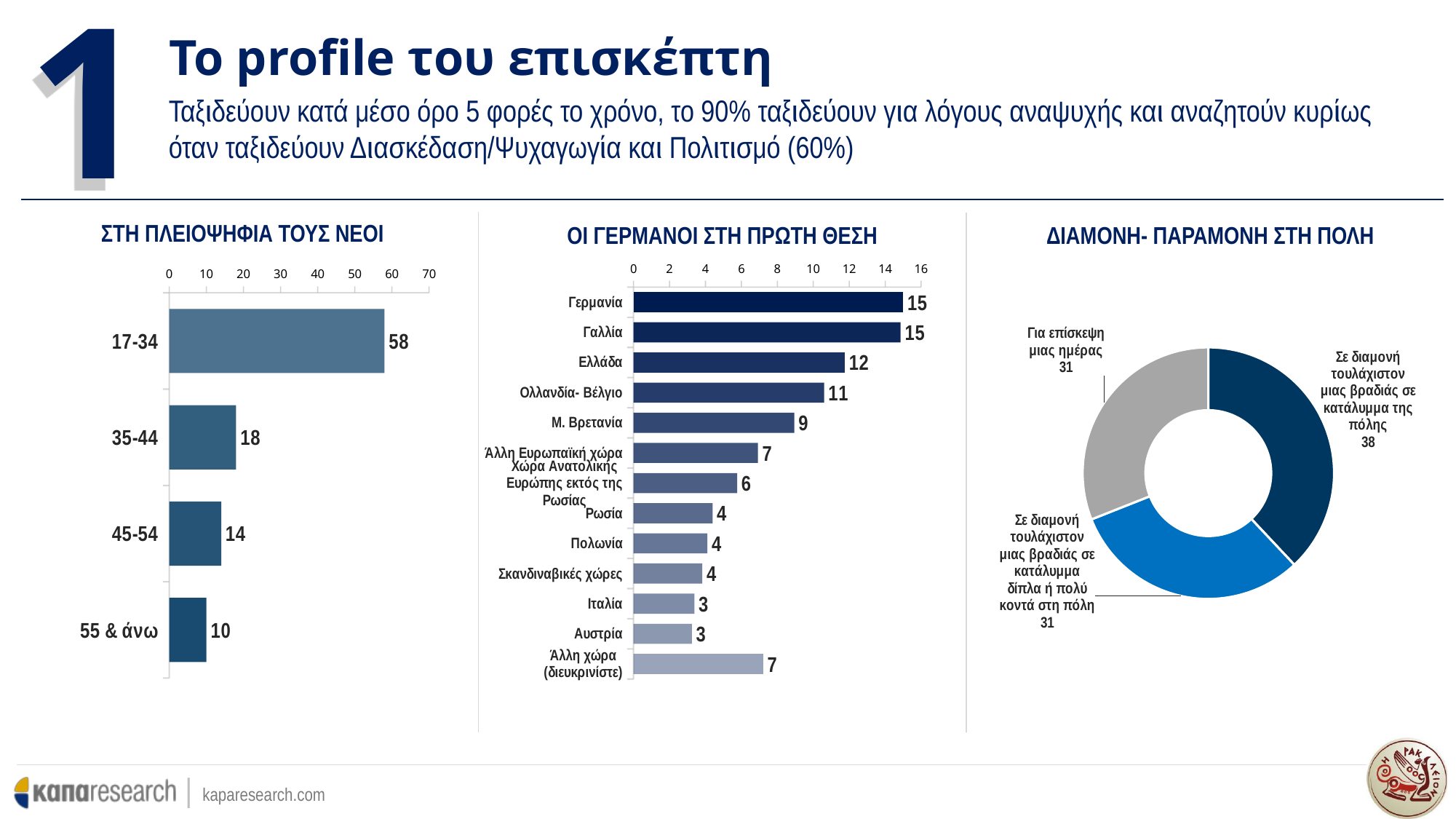
In the chart titled 'ΟΙ ΓΕΡΜΑΝΟΙ ΣΤΗ ΠΡΩΤΗ ΘΕΣΗ', what is the value for Ελλάδα? 12 What kind of chart is the one titled 'ΣΤΗ ΠΛΕΙΟΨΗΦΙΑ ΤΟΥΣ ΝΕΟΙ'? Bar chart In the chart titled 'ΣΤΗ ΠΛΕΙΟΨΗΦΙΑ ΤΟΥΣ ΝΕΟΙ', what is the difference between the values for 35-44 and 45-54? 4 In the chart titled 'ΟΙ ΓΕΡΜΑΝΟΙ ΣΤΗ ΠΡΩΤΗ ΘΕΣΗ', how many categories are shown? 13 In the chart titled 'ΟΙ ΓΕΡΜΑΝΟΙ ΣΤΗ ΠΡΩΤΗ ΘΕΣΗ', what is the difference between the values for Γερμανία and Ιταλία? 12 In the chart titled 'ΔΙΑΜΟΝΗ- ΠΑΡΑΜΟΝΗ ΣΤΗ ΠΟΛΗ', what is the value for 'Για επίσκεψη μιας ημέρας'? 31 In the chart titled 'ΣΤΗ ΠΛΕΙΟΨΗΦΙΑ ΤΟΥΣ ΝΕΟΙ', what is the value for the 17-34 age group? 58 In the chart titled 'ΣΤΗ ΠΛΕΙΟΨΗΦΙΑ ΤΟΥΣ ΝΕΟΙ', how many age groups are shown? 4 In the chart titled 'ΟΙ ΓΕΡΜΑΝΟΙ ΣΤΗ ΠΡΩΤΗ ΘΕΣΗ', what is the value for Μ. Βρετανία? 9 In the chart titled 'ΟΙ ΓΕΡΜΑΝΟΙ ΣΤΗ ΠΡΩΤΗ ΘΕΣΗ', which is larger, the value for Ολλανδία- Βέλγιο or the value for Ρωσία? Ολλανδία- Βέλγιο In the chart titled 'ΔΙΑΜΟΝΗ- ΠΑΡΑΜΟΝΗ ΣΤΗ ΠΟΛΗ', which category has the highest value? Σε διαμονή τουλάχιστον μιας βραδιάς σε κατάλυμμα της πόλης In the chart titled 'ΣΤΗ ΠΛΕΙΟΨΗΦΙΑ ΤΟΥΣ ΝΕΟΙ', which age group has the lowest value? 55 & άνω